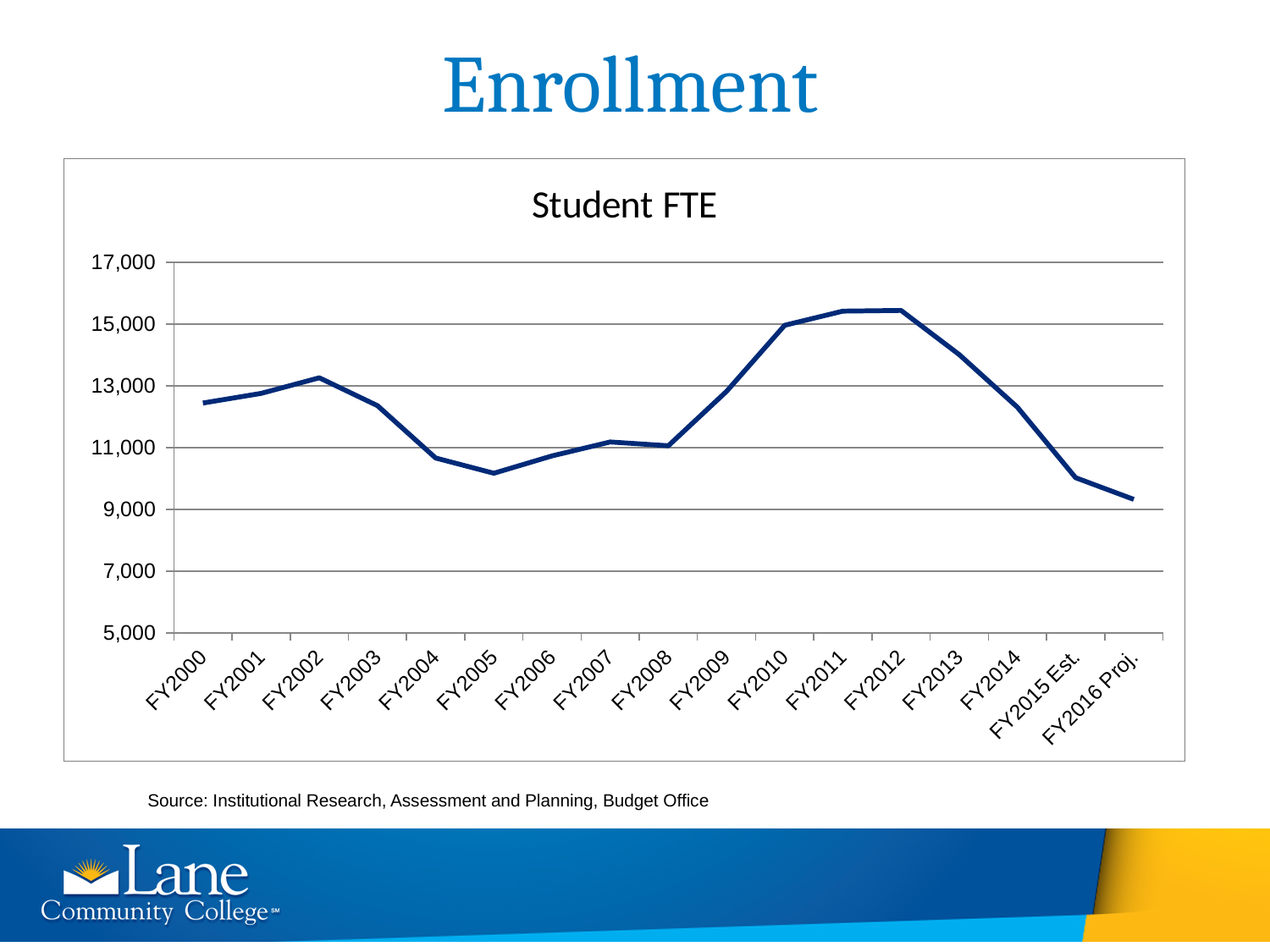
Is the Student FTE for FY2000 greater or less than 13,000? less What is the title of the chart? Student FTE How many fiscal years are plotted on the x axis? 17 What kind of chart is shown on the slide? line chart Is the Student FTE for FY2016 Proj. greater or less than 11,000? less Does the Student FTE rise or fall from FY2005 to FY2011? rise Which fiscal year has the lowest Student FTE? FY2016 Proj. Does the Student FTE rise or fall from FY2012 to FY2016 Proj.? fall Is the Student FTE for FY2005 greater or less than 11,000? less Which has the higher Student FTE, FY2002 or FY2005? FY2002 Which has the higher Student FTE, FY2010 or FY2000? FY2010